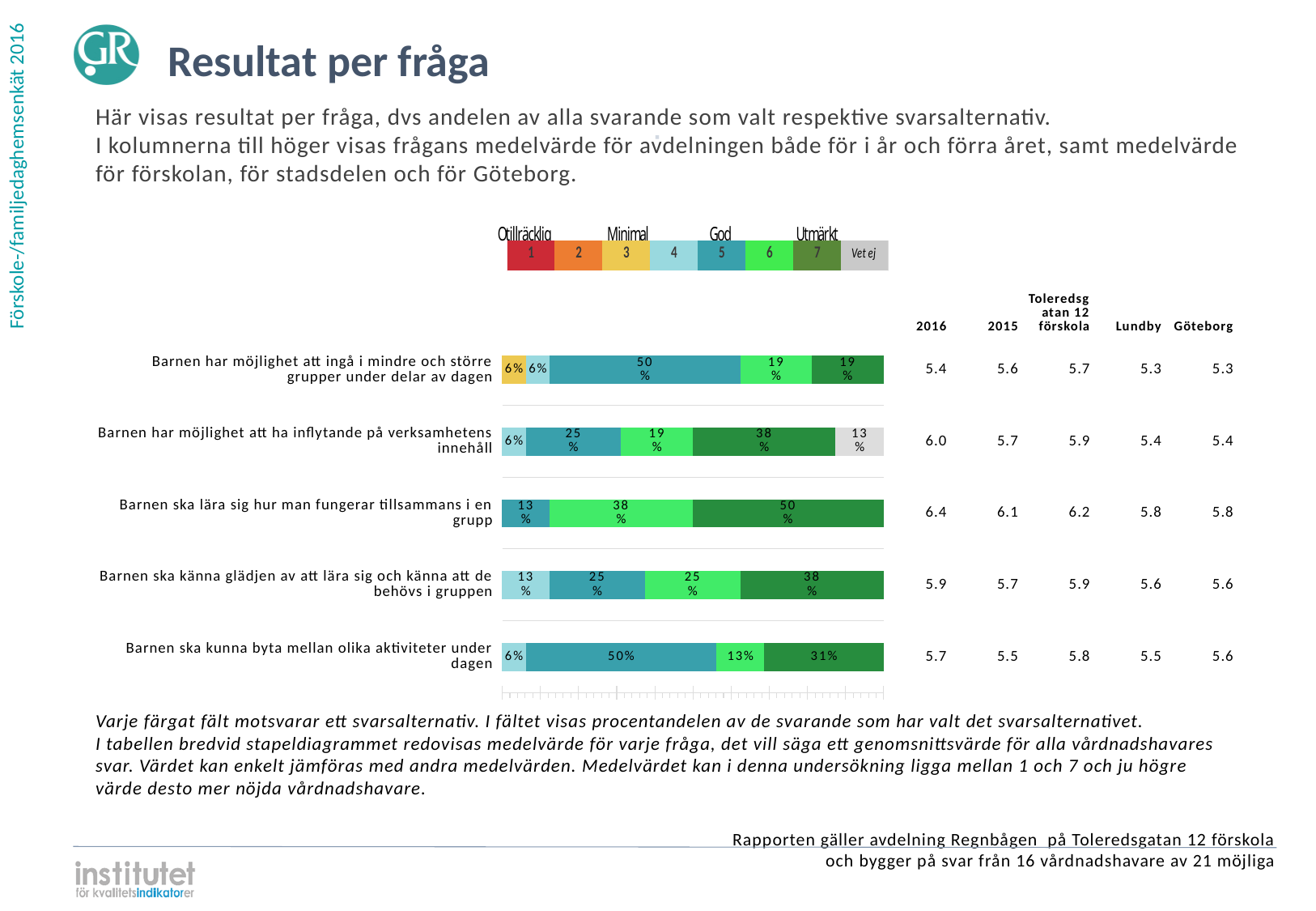
Which question has the largest share of option 7 (Utmärkt) answers? Barnen ska lära sig hur man fungerar tillsammans i en grupp What share of respondents answered 'Vet ej' for 'Barnen har möjlighet att ha inflytande på verksamhetens innehåll'? 13% What percentage of respondents chose option 5 (God) for 'Barnen har möjlighet att ingå i mindre och större grupper under delar av dagen'? 50% What is the 2016 mean value for 'Barnen ska lära sig hur man fungerar tillsammans i en grupp'? 6.4 For 'Barnen ska känna glädjen av att lära sig och känna att de behövs i gruppen', which is larger: the share for option 6 or the share for option 7? Option 7 (38%) How many questions (categories) are shown in the bar chart? 5 Which question has the lowest 2016 mean value in the table? Barnen har möjlighet att ingå i mindre och större grupper under delar av dagen What kind of chart is used to show the results per question? Stacked bar chart For 'Barnen ska kunna byta mellan olika aktiviteter under dagen', what is the difference between the option 5 share and the option 7 share? 19 percentage points How many answer options does the legend above the chart list? 8 What colour represents answer option 7 (Utmärkt) in the legend? Dark green What percentage chose option 7 (Utmärkt) for 'Barnen ska lära sig hur man fungerar tillsammans i en grupp'? 50%